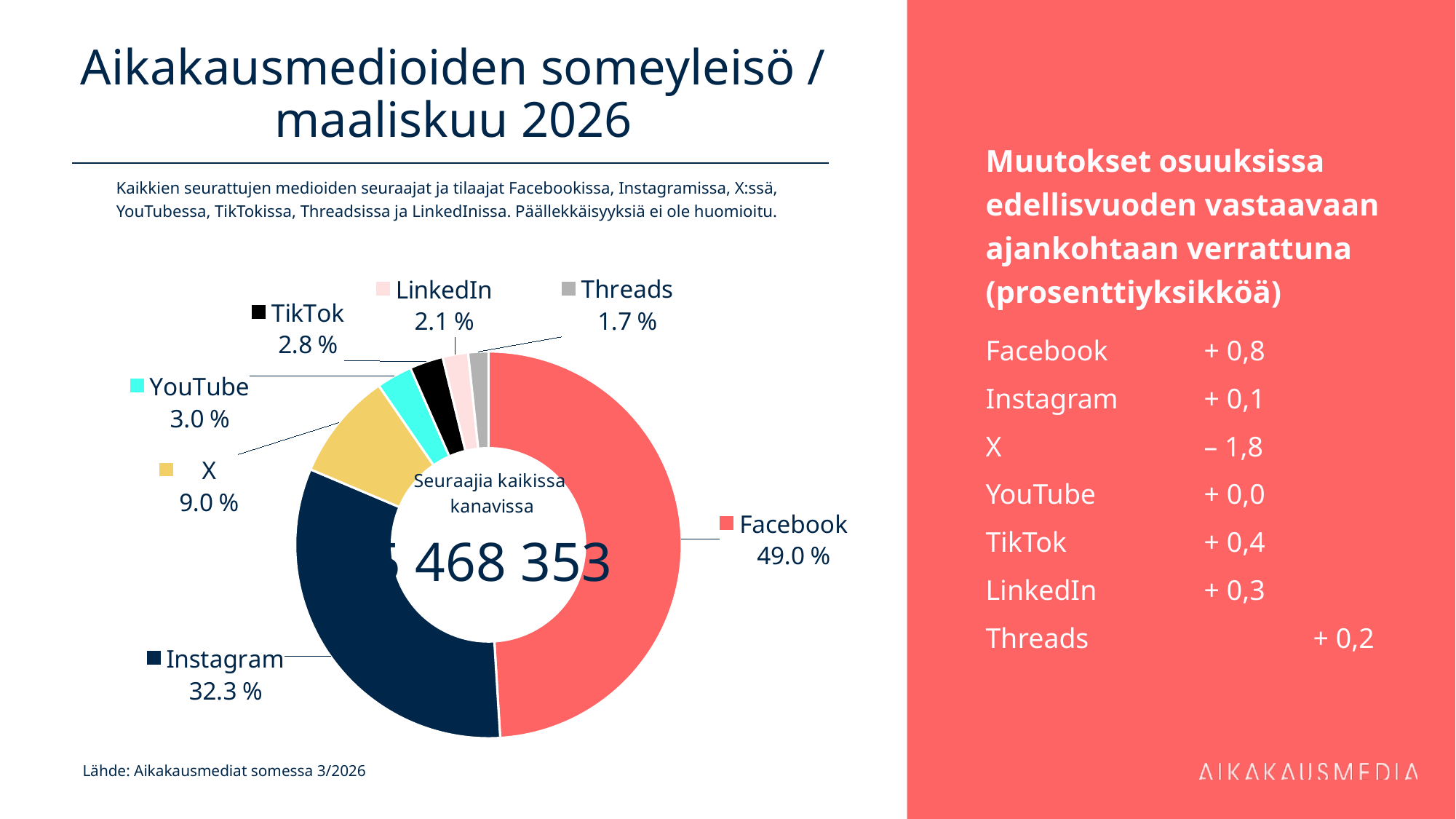
What is the difference in percentage points between TikTok's and LinkedIn's shares? 0.7 What share of the social media audience does Instagram have? 32.3 % Which platform has the smallest share in the chart? Threads What share of the social media audience does Facebook have? 49.0 % Which platform has the largest share in the chart? Facebook How many platforms (slices) are shown in the chart? 7 What is the difference in percentage points between Facebook's and Instagram's shares? 16.7 What is the value shown for X in the chart? 9.0 % What colour is the Instagram slice in the chart? Dark navy blue What is the value shown for Threads in the chart? 1.7 % What kind of chart is shown on the slide? Pie chart (donut) Which has a larger share, YouTube or TikTok? YouTube